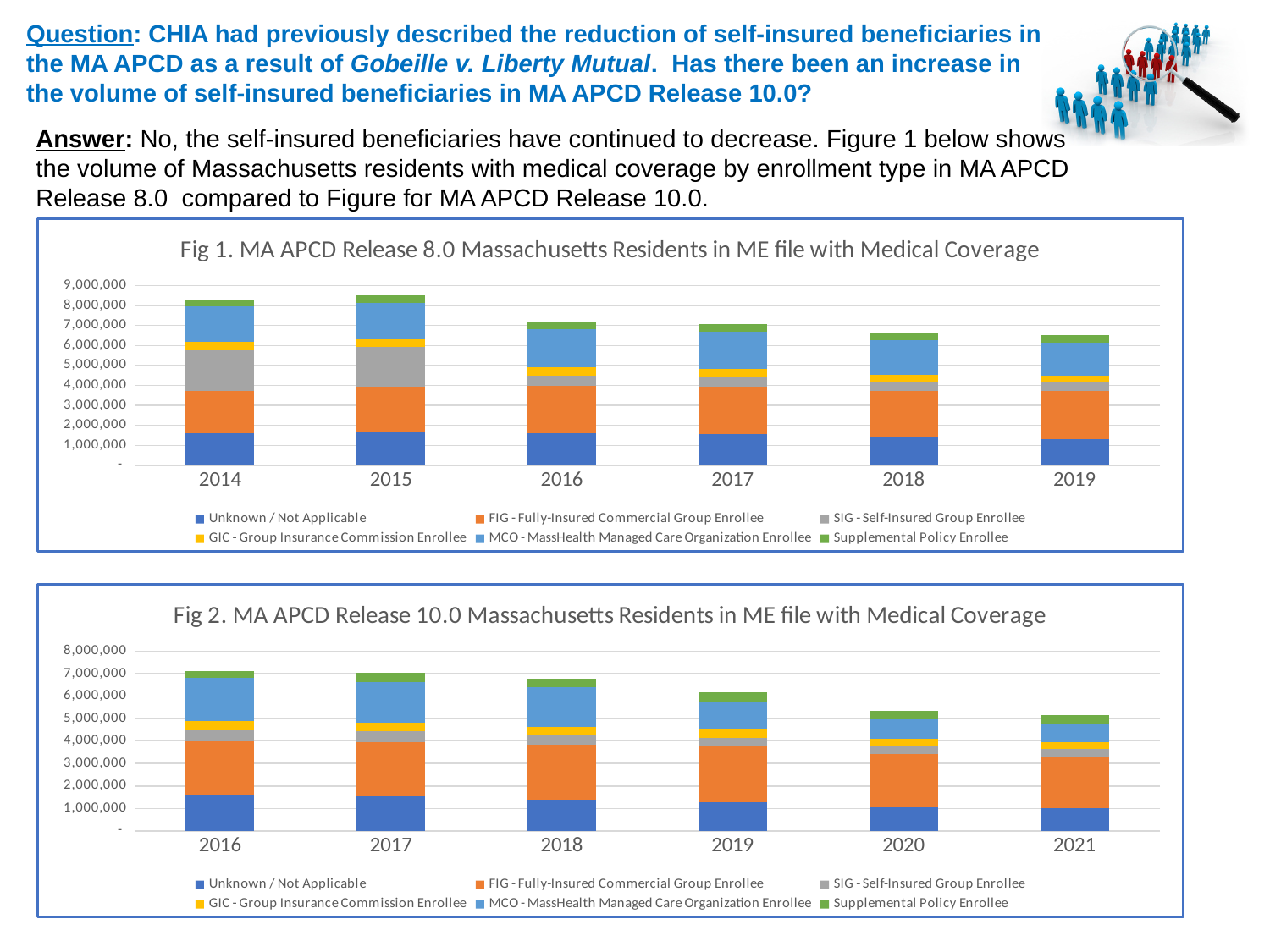
In Fig 2, do the total stacked bars rise or fall from 2016 to 2021? Fall In Fig 2, is the total for 2020 greater or less than 6,000,000? less What kind of chart is Fig 1? Stacked bar chart In Fig 1, which year has the highest total stacked bar? 2015 In Fig 1, is the total for 2019 greater or less than 7,000,000? less In Fig 1, is the total for 2016 greater or less than 8,000,000? less Which legend entry in Fig 2 is shown in gray? SIG - Self-Insured Group Enrollee How many years are shown on the x axis of Fig 2? 6 How many years are shown on the x axis of Fig 1? 6 How many series does the legend of Fig 1 list? 6 In Fig 2, which is larger, the total for 2016 or the total for 2021? 2016